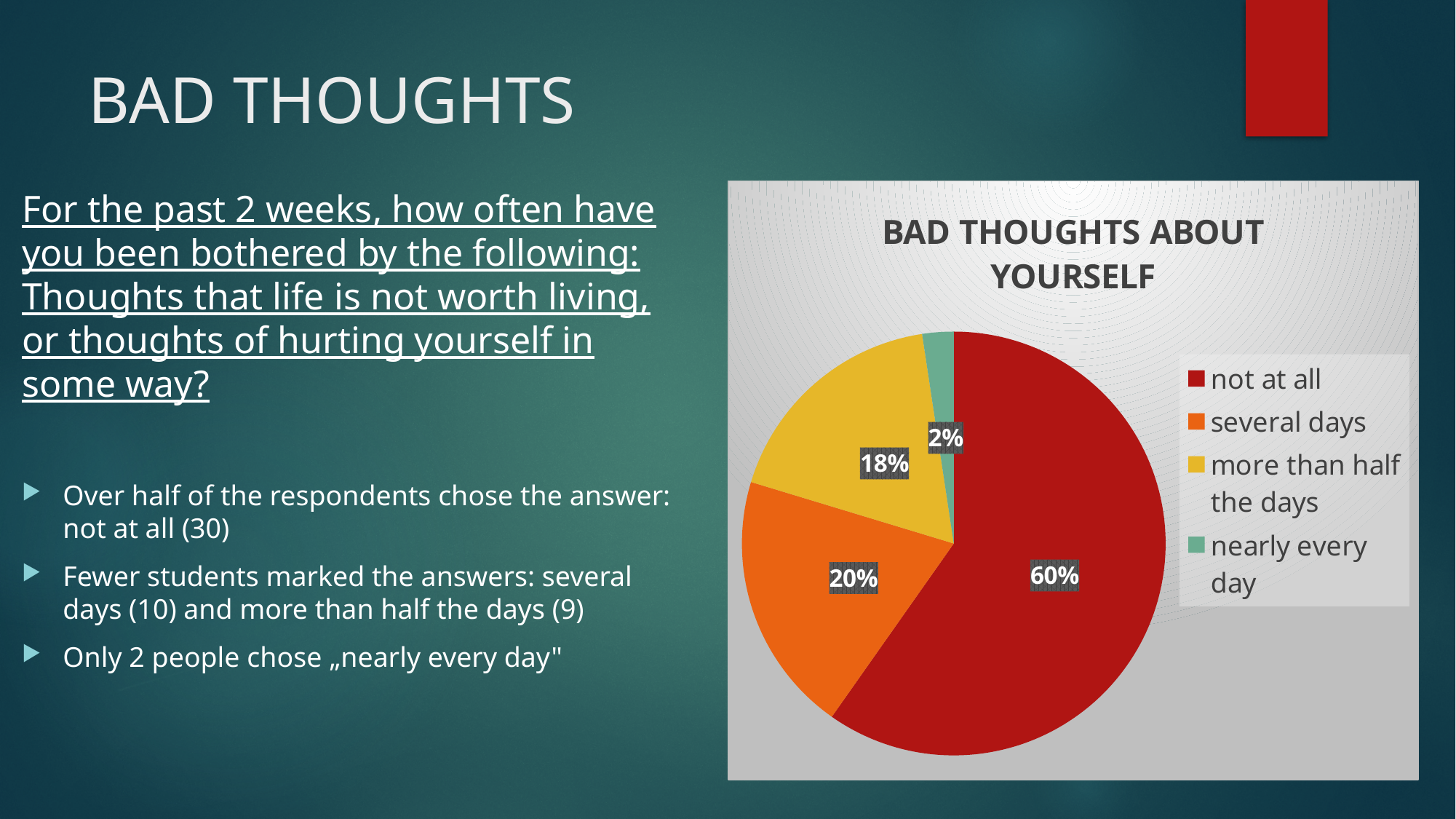
What kind of chart is shown on the slide? pie chart What percentage of the pie is labelled for "nearly every day"? 2% How many categories does the legend list? 4 Which category has the largest slice of the pie? not at all What colour is the slice for "more than half the days"? yellow What is the difference in percentage points between "not at all" and "several days"? 40 Which category has the smallest slice of the pie? nearly every day What percentage of the pie is labelled for "more than half the days"? 18% What is the title of the chart? BAD THOUGHTS ABOUT YOURSELF What percentage of the pie is labelled for "several days"? 20% Which is larger, the slice for "several days" or the slice for "more than half the days"? several days What percentage of the pie is labelled for "not at all"? 60%